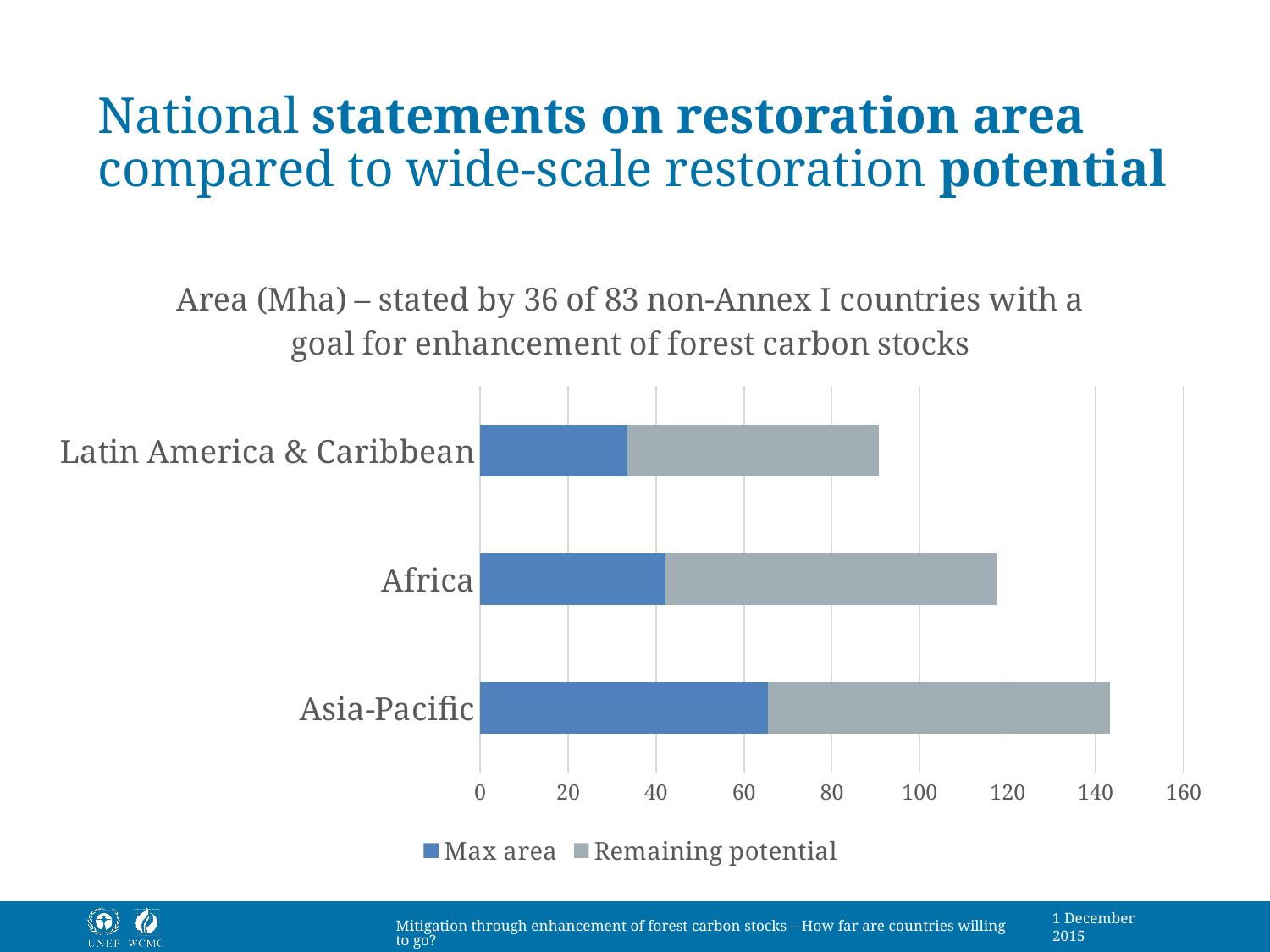
How many regions are shown on the chart? 3 Is the Max area value for Latin America & Caribbean greater or less than 40? less What are the two series named in the legend? Max area and Remaining potential Is the Max area value for Asia-Pacific greater or less than 60? greater Is the total bar for Latin America & Caribbean greater or less than 100? less Which region has the longest total bar (Max area plus Remaining potential)? Asia-Pacific Which region has the largest Max area segment? Asia-Pacific Is the total bar for Africa longer or shorter than the total bar for Latin America & Caribbean? Longer How many series does the legend list? 2 Which region has the shortest total bar? Latin America & Caribbean What kind of chart is shown on the slide? Stacked bar chart